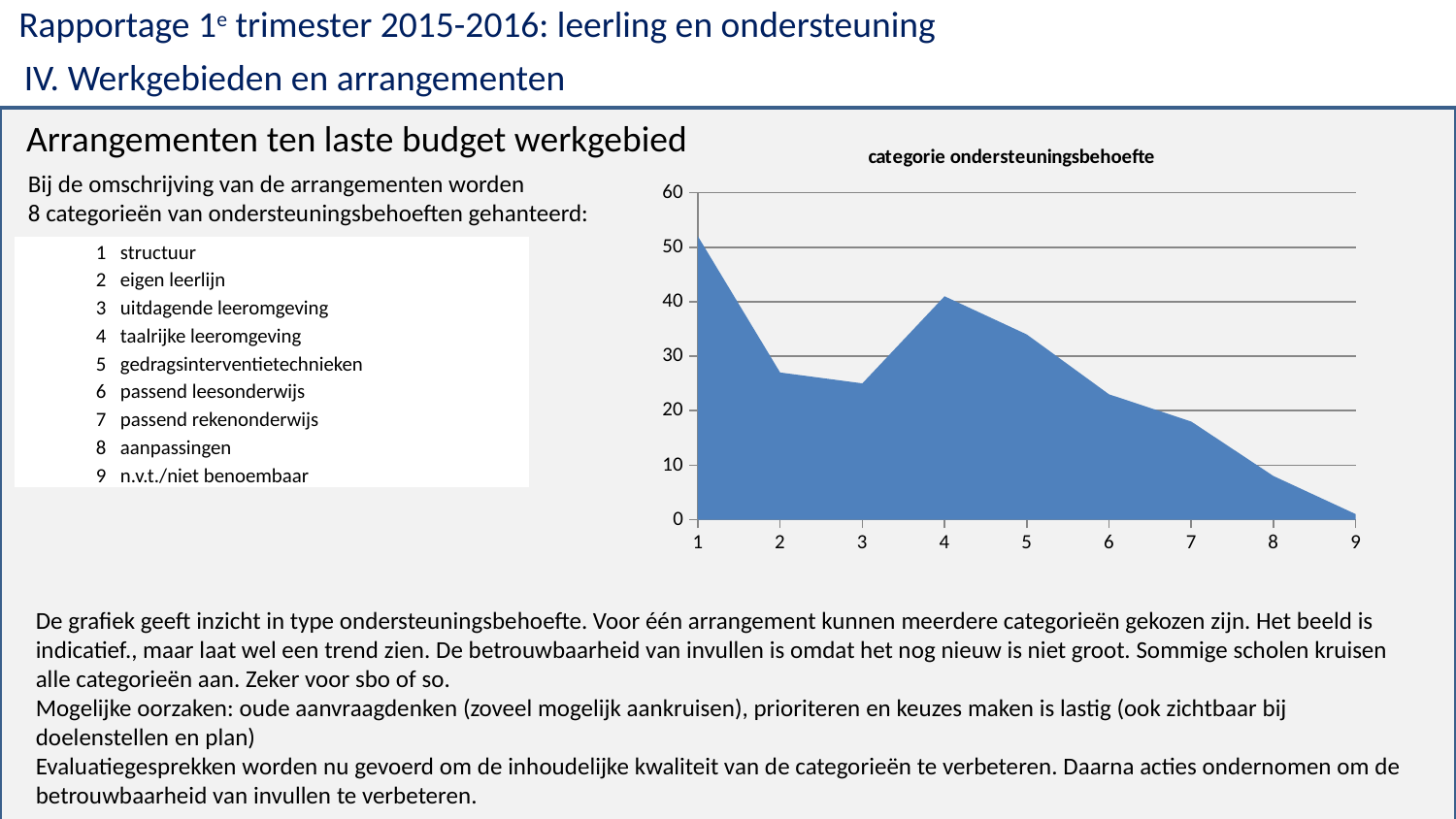
Is the value for category 8 greater or less than 10? less Do the values rise or fall from category 4 to category 9? fall How many categories are plotted along the x axis of the chart? 9 Which category has the lowest value in the chart? 9 Which has a larger value, category 4 or category 2? 4 What kind of chart is shown on the slide? area chart Is the value for category 6 greater or less than 20? greater Which category has the highest value in the chart? 1 What is the title of the chart? categorie ondersteuningsbehoefte Is the value for category 1 greater or less than 50? greater Which has a larger value, category 7 or category 5? 5